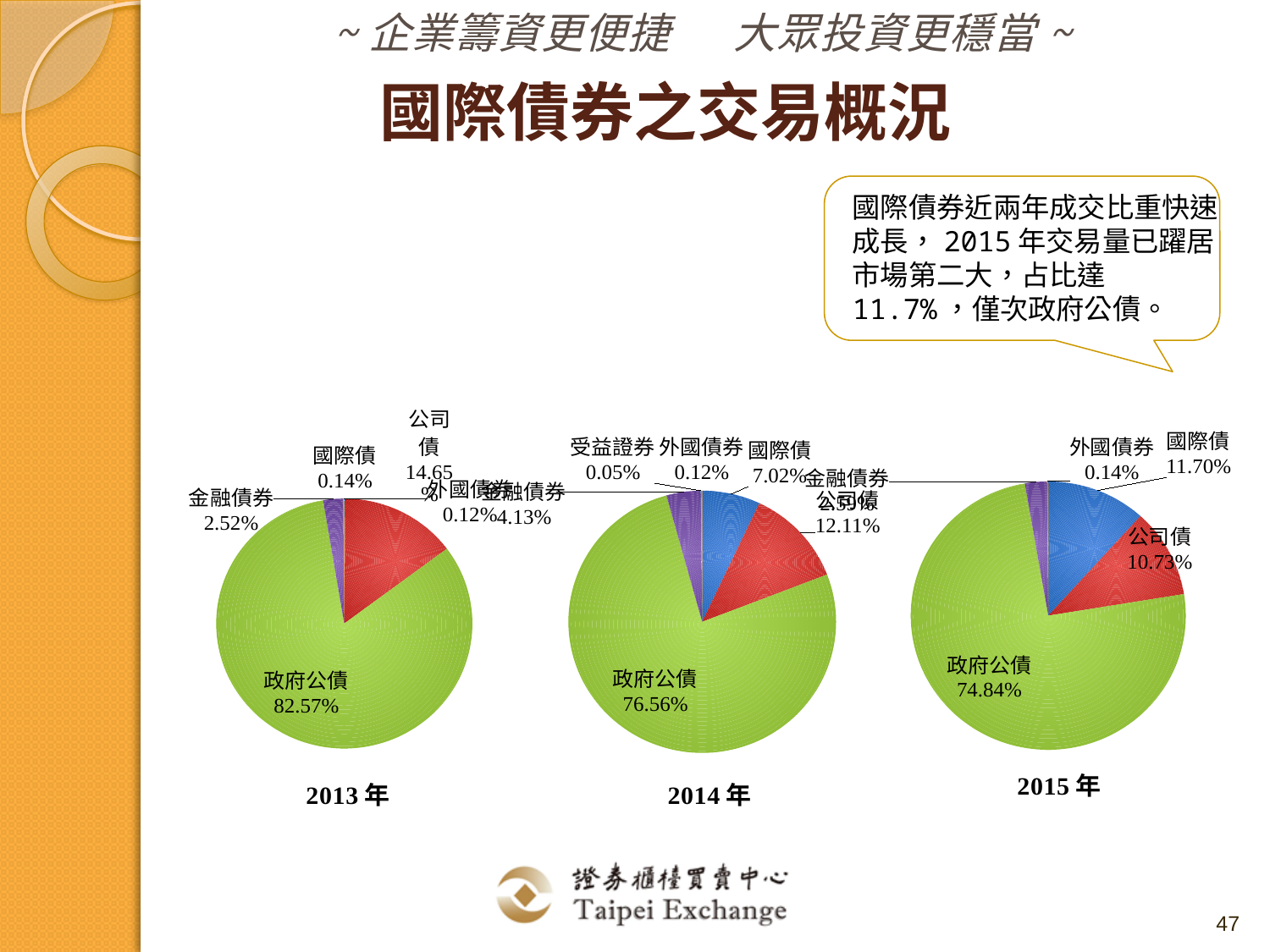
What type of chart is used for the 2015年 data? pie chart In the 2013年 pie chart, which category has the smallest share? 外國債券 In the 2014年 pie chart, what share does 受益證券 have? 0.05% In the 2015年 pie chart, what is the difference between the shares of 國際債 and 公司債? 0.97% In the 2015年 pie chart, which is larger: 國際債 or 公司債? 國際債 In the 2013年 pie chart, what share does 金融債券 have? 2.52% In the 2015年 pie chart, which category has the largest share? 政府公債 Across the three pie charts from 2013年 to 2015年, does the share of 國際債 rise or fall? rise In the 2014年 pie chart, what share does 國際債 have? 7.02% In the 2015年 pie chart, what share does 公司債 have? 10.73% In the 2015年 pie chart, what share does 國際債 have? 11.70% In the 2013年 pie chart, what share does 政府公債 have? 82.57%